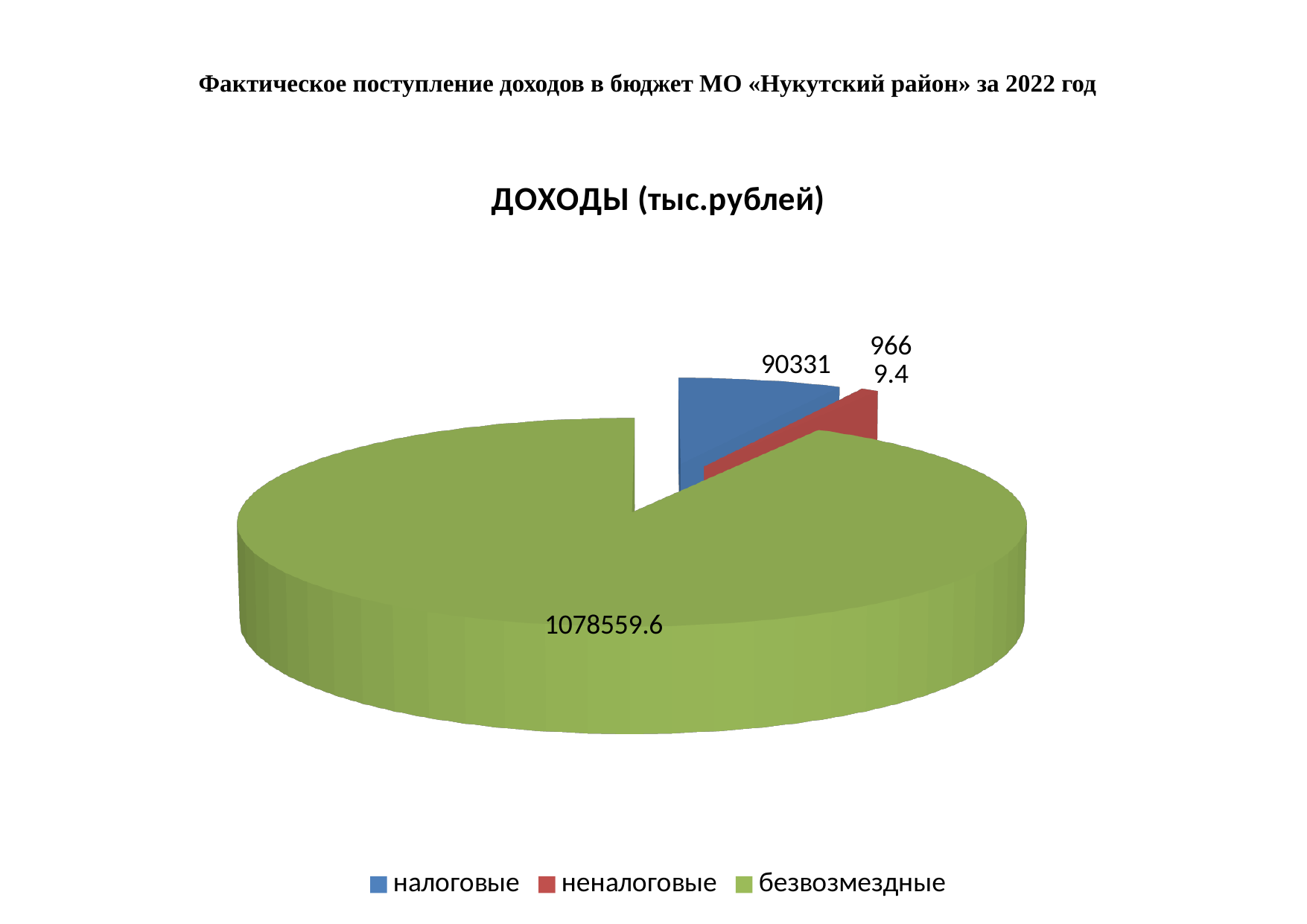
What is the value for налоговые? 90331 What is the value for безвозмездные? 1078559.6 Which category has the largest slice? безвозмездные What kind of chart is shown on the slide? pie chart How many slices does the pie chart have? 3 Which is larger, налоговые or неналоговые? налоговые Which category has the smallest slice? неналоговые How many entries does the legend list? 3 What is the title of the chart? ДОХОДЫ (тыс.рублей) What colour is the безвозмездные slice? green Which is larger, безвозмездные or налоговые? безвозмездные What is the difference between the values for безвозмездные and налоговые? 988228.6